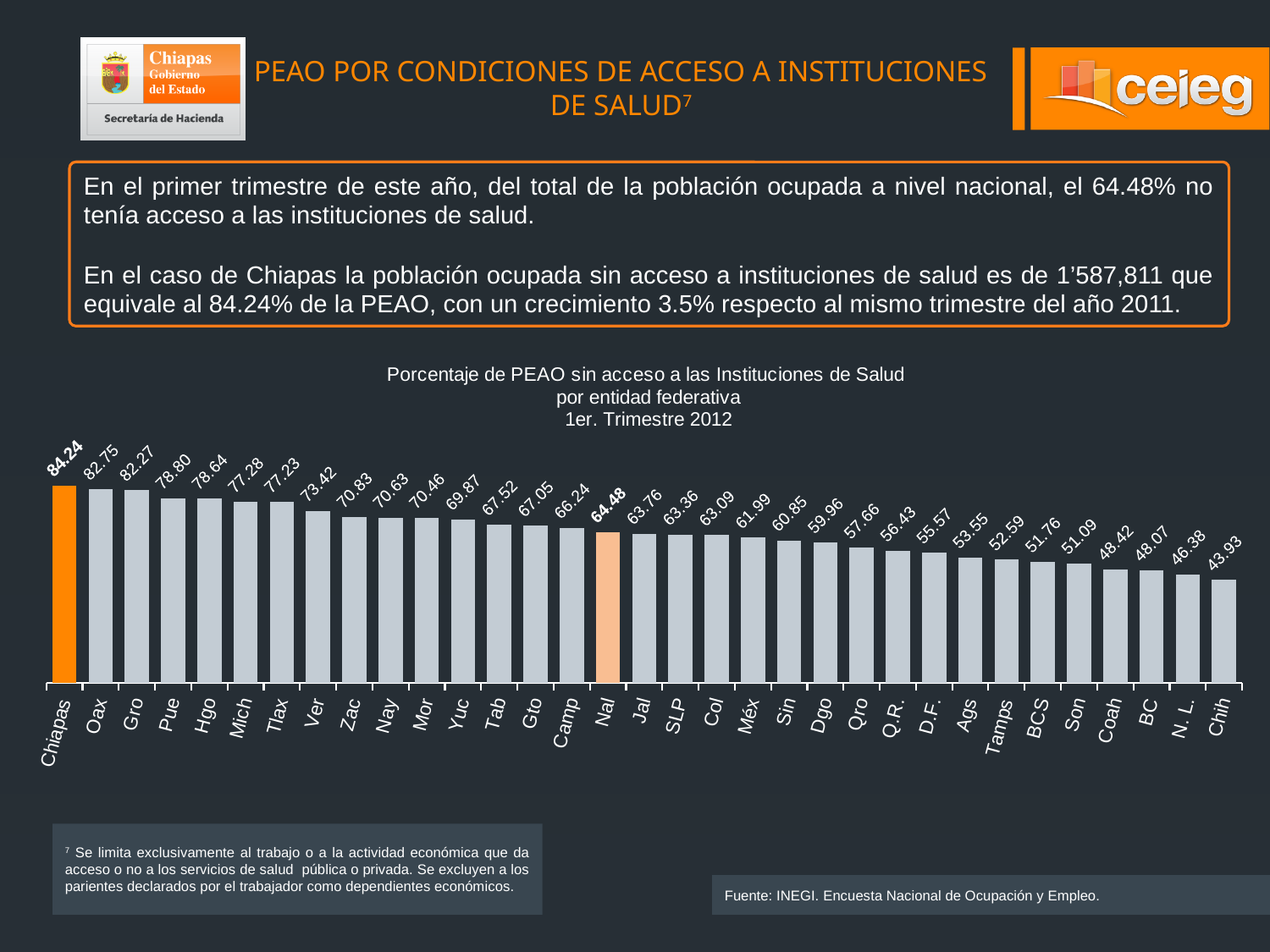
What is the value shown for Nal (national)? 64.48 Which entity has the lowest percentage of PEAO without access to health institutions? Chih Which has a higher value, Oax or Pue? Oax Do the values rise or fall moving from left to right along the x axis? Fall What is the value shown for Chiapas? 84.24 What is the difference between the value for Chiapas and the value for Nal? 19.76 What type of chart is shown on the slide? Bar chart What is the difference between the value for Chiapas and the value for Chih? 40.31 What is the value shown for D.F.? 55.57 Which entity has the highest percentage of PEAO without access to health institutions? Chiapas How many bars are plotted in the chart? 33 What is the value shown for Ver? 73.42